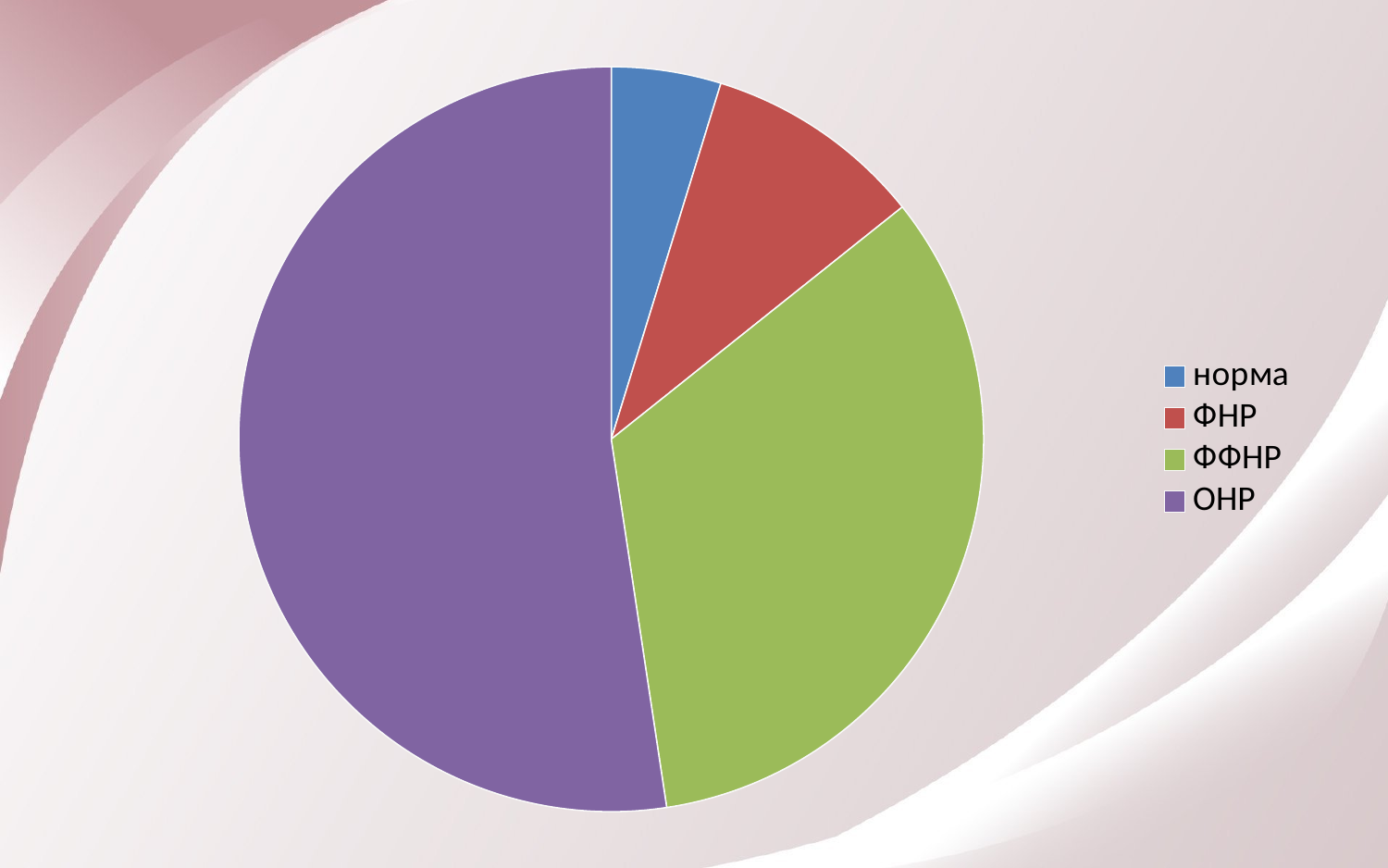
Which slice is larger, ФФНР or ФНР? ФФНР Which slice is larger, ФНР or норма? ФНР What colour is the ОНР slice? purple How many entries does the legend list? 4 Which slice is smaller, норма or ФФНР? норма Which category is shown in green? ФФНР Which category has the smallest slice of the pie? норма What kind of chart is shown on the slide? pie chart How many slices does the pie chart have? 4 Which category has the largest slice of the pie? ОНР